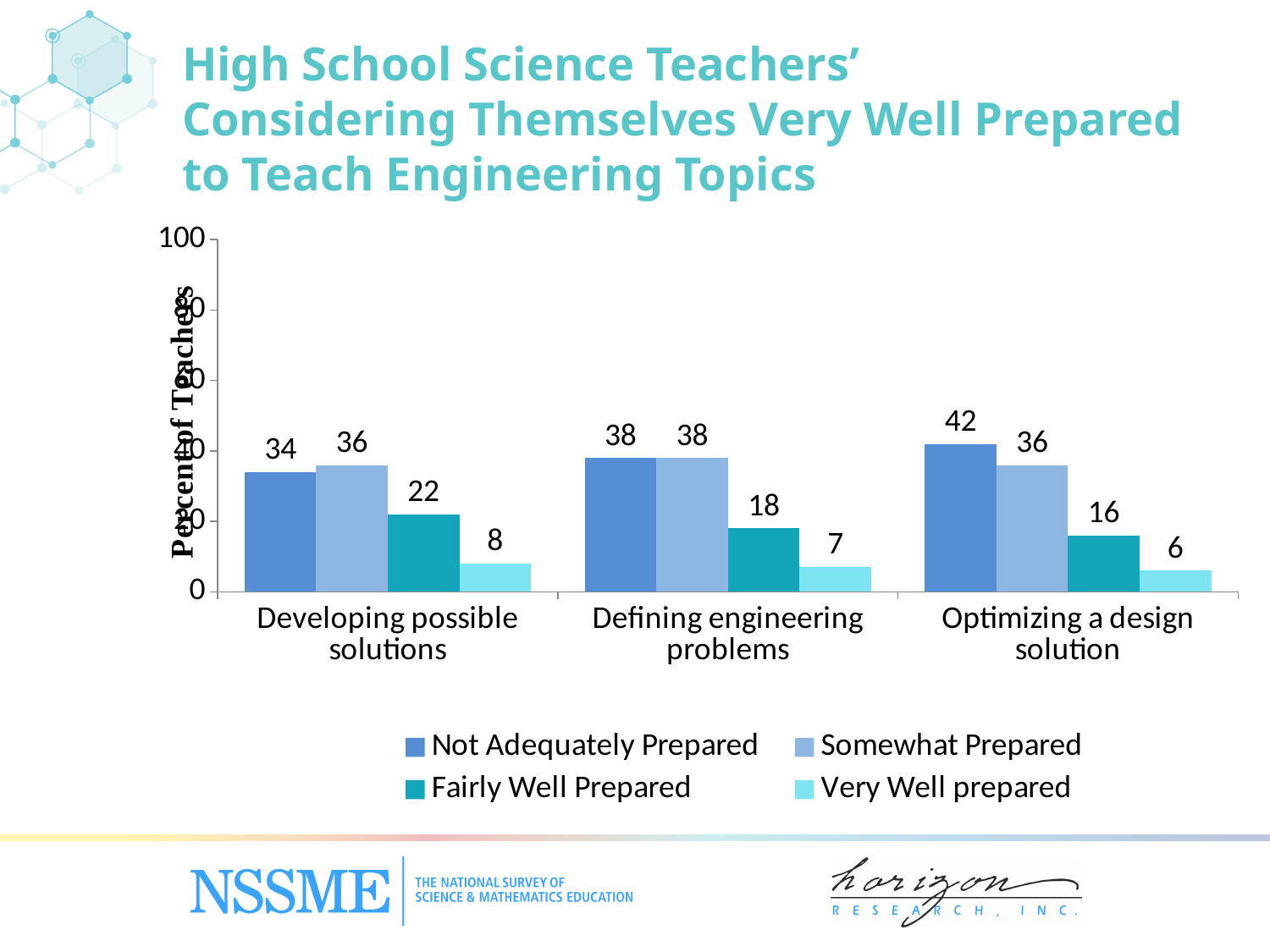
Which series is shown in the lightest blue colour? Very Well prepared Which category has the highest value for Not Adequately Prepared? Optimizing a design solution How many series does the legend list? 4 What is the label of the y axis? Percent of Teachers What is the value for Not Adequately Prepared in the Developing possible solutions category? 34 What kind of chart is shown on the slide? Bar chart Which is larger in the Optimizing a design solution category: Not Adequately Prepared or Somewhat Prepared? Not Adequately Prepared Which category has the lowest value for Very Well prepared? Optimizing a design solution What is the value for Very Well prepared in the Defining engineering problems category? 7 What is the value for Fairly Well Prepared in the Optimizing a design solution category? 16 What is the difference between the Somewhat Prepared and Fairly Well Prepared values in the Developing possible solutions category? 14 How many categories are shown on the x axis? 3